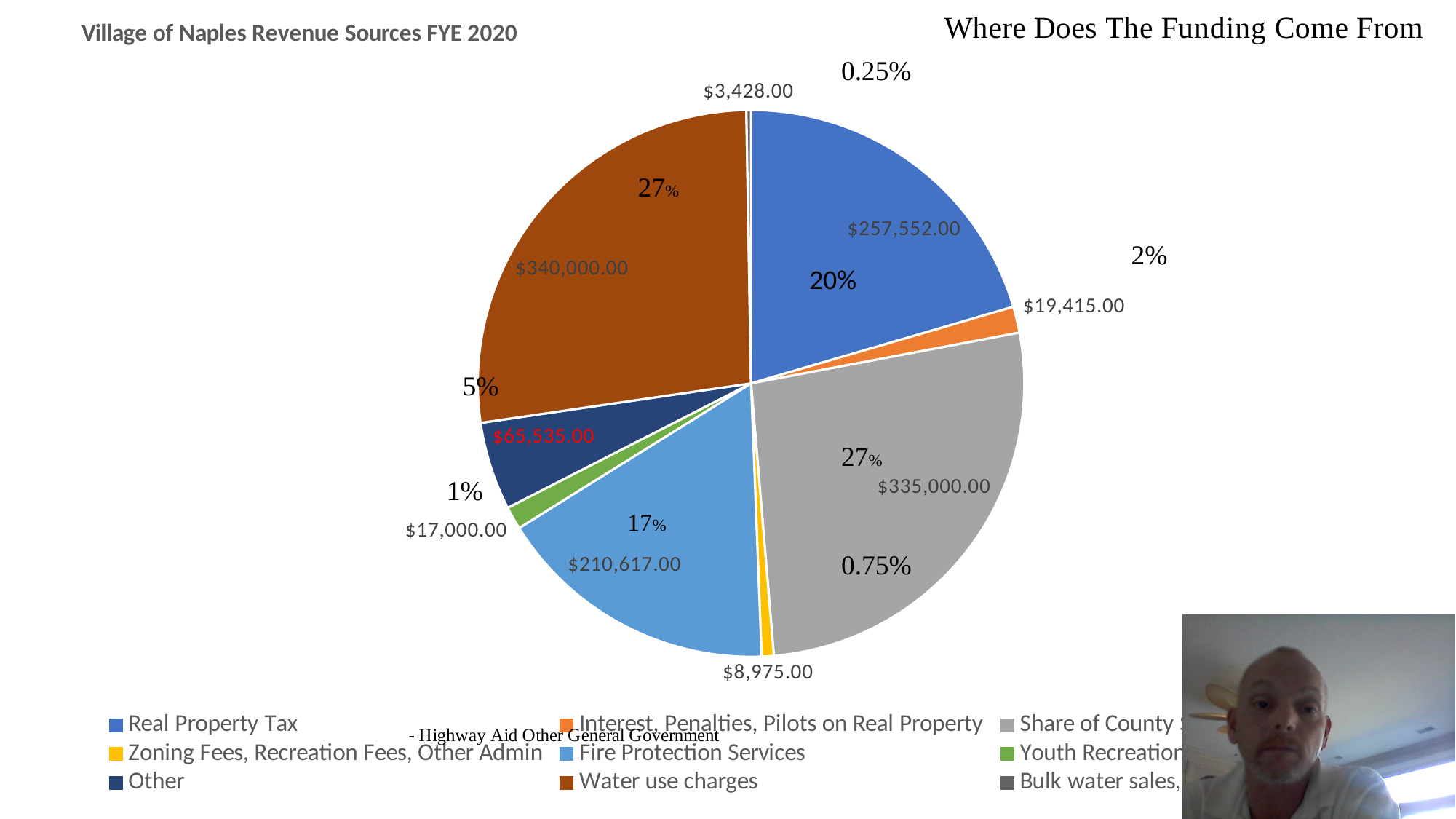
What is the value for Real Property Tax? $257,552.00 Which revenue source has the largest value? Water use charges Which is larger, Fire Protection Services or Real Property Tax? Real Property Tax What is the value for Interest, Penalties, Pilots on Real Property? $19,415.00 What kind of chart is shown on the slide? Pie chart What is the value for Water use charges? $340,000.00 How many slices does the pie chart have? 9 What share of the pie does Real Property Tax represent? 20% Which revenue source has the smallest value? Bulk water sales What is the value for Other? $65,535.00 What is the value for Fire Protection Services? $210,617.00 What is the difference between Water use charges and Real Property Tax? $82,448.00